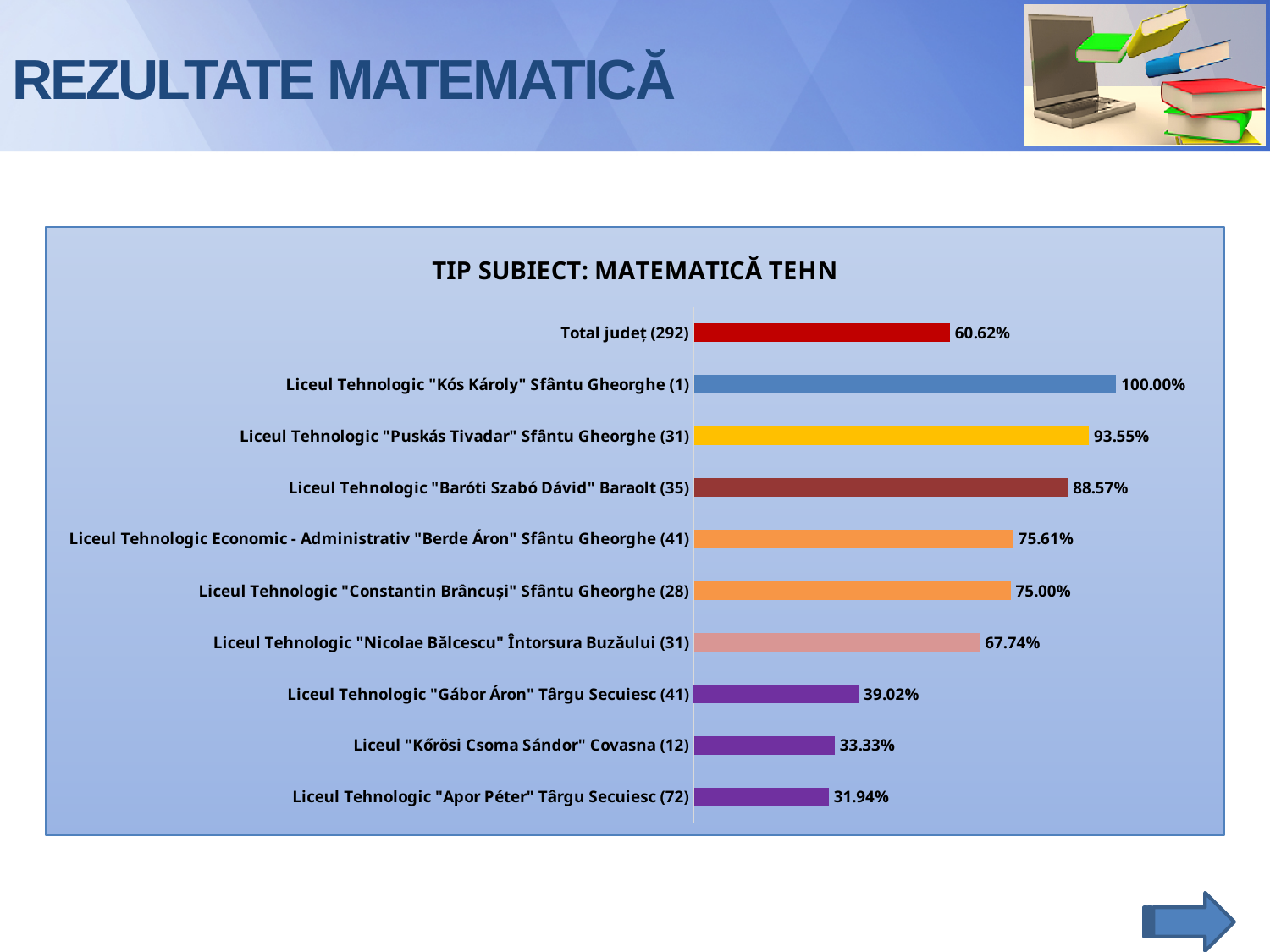
What is the value for Liceul Tehnologic "Gábor Áron" Târgu Secuiesc (41)? 39.02% What is the value for Total județ (292)? 60.62% What is the value for Liceul Tehnologic "Puskás Tivadar" Sfântu Gheorghe (31)? 93.55% Which is larger: the value for Liceul "Kőrösi Csoma Sándor" Covasna (12) or Liceul Tehnologic "Apor Péter" Târgu Secuiesc (72)? Liceul "Kőrösi Csoma Sándor" Covasna (12) How many categories (bars) are shown in the chart? 10 Which category has the highest value? Liceul Tehnologic "Kós Károly" Sfântu Gheorghe (1) What is the title of the chart? TIP SUBIECT: MATEMATICĂ TEHN What is the difference between the value for Liceul Tehnologic "Kós Károly" Sfântu Gheorghe (1) and Total județ (292)? 39.38% Which category has the lowest value? Liceul Tehnologic "Apor Péter" Târgu Secuiesc (72) What kind of chart is shown on the slide? Bar chart What is the difference between the values for Liceul Tehnologic "Baróti Szabó Dávid" Baraolt (35) and Liceul Tehnologic "Nicolae Bălcescu" Întorsura Buzăului (31)? 20.83% What is the value for Liceul Tehnologic "Constantin Brâncuși" Sfântu Gheorghe (28)? 75.00%